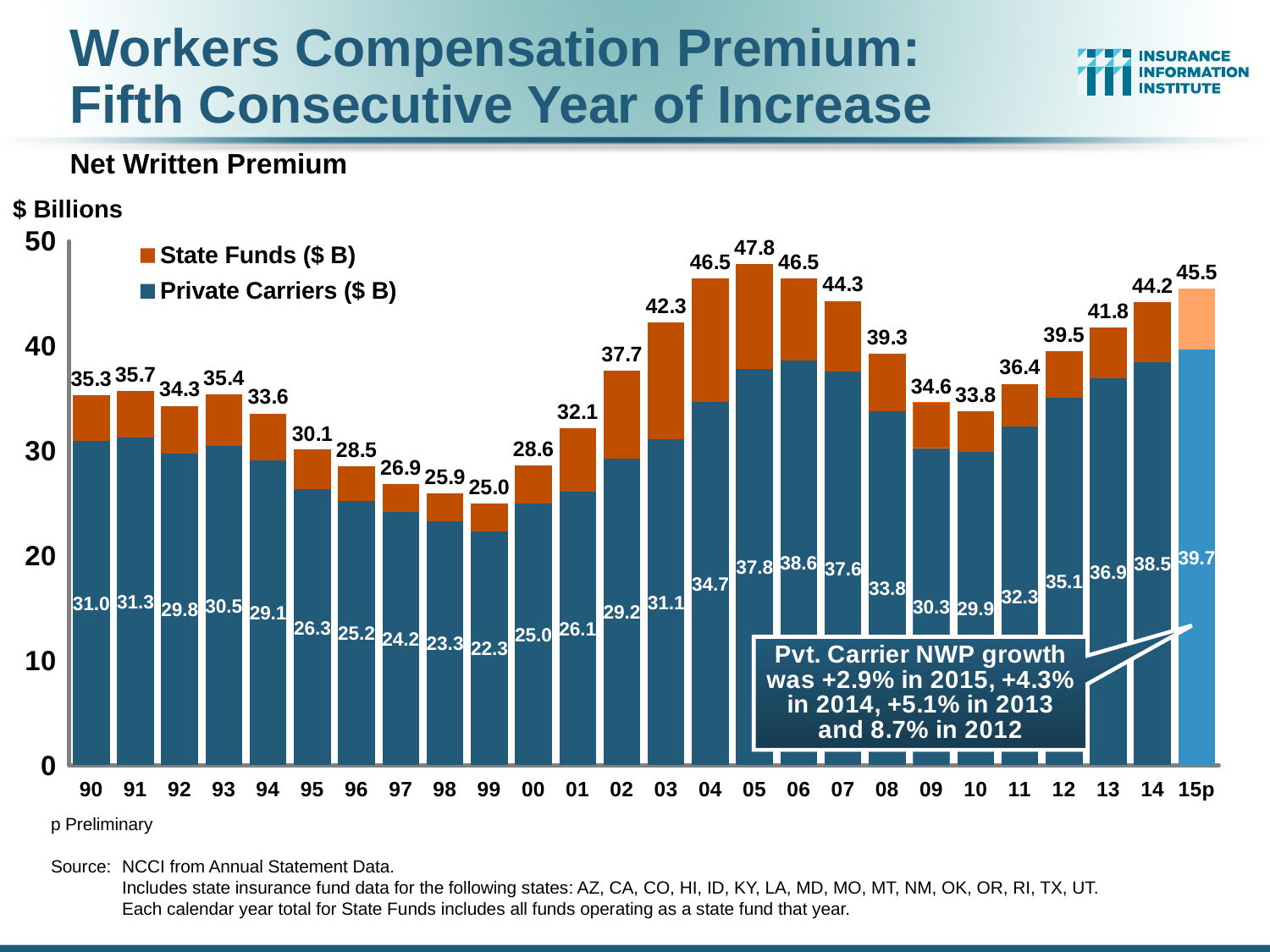
What kind of chart is shown on the slide? Stacked bar chart Do the total values rise or fall from 99 to 05? Rise What unit is shown on the y axis label? $ Billions What is the total net written premium shown for 2005? 47.8 Which year has the lowest total net written premium? 99 What is the difference between the total for 15p and the total for 14? 1.3 Based on the printed labels, what is the State Funds portion for 2005 (total minus Private Carriers)? 10.0 Which year has the highest total net written premium? 05 What is the Private Carriers value shown for 15p? 39.7 How many years are shown on the x axis? 26 How many series does the legend list? 2 Which is larger, the total for 03 or the total for 13? 03